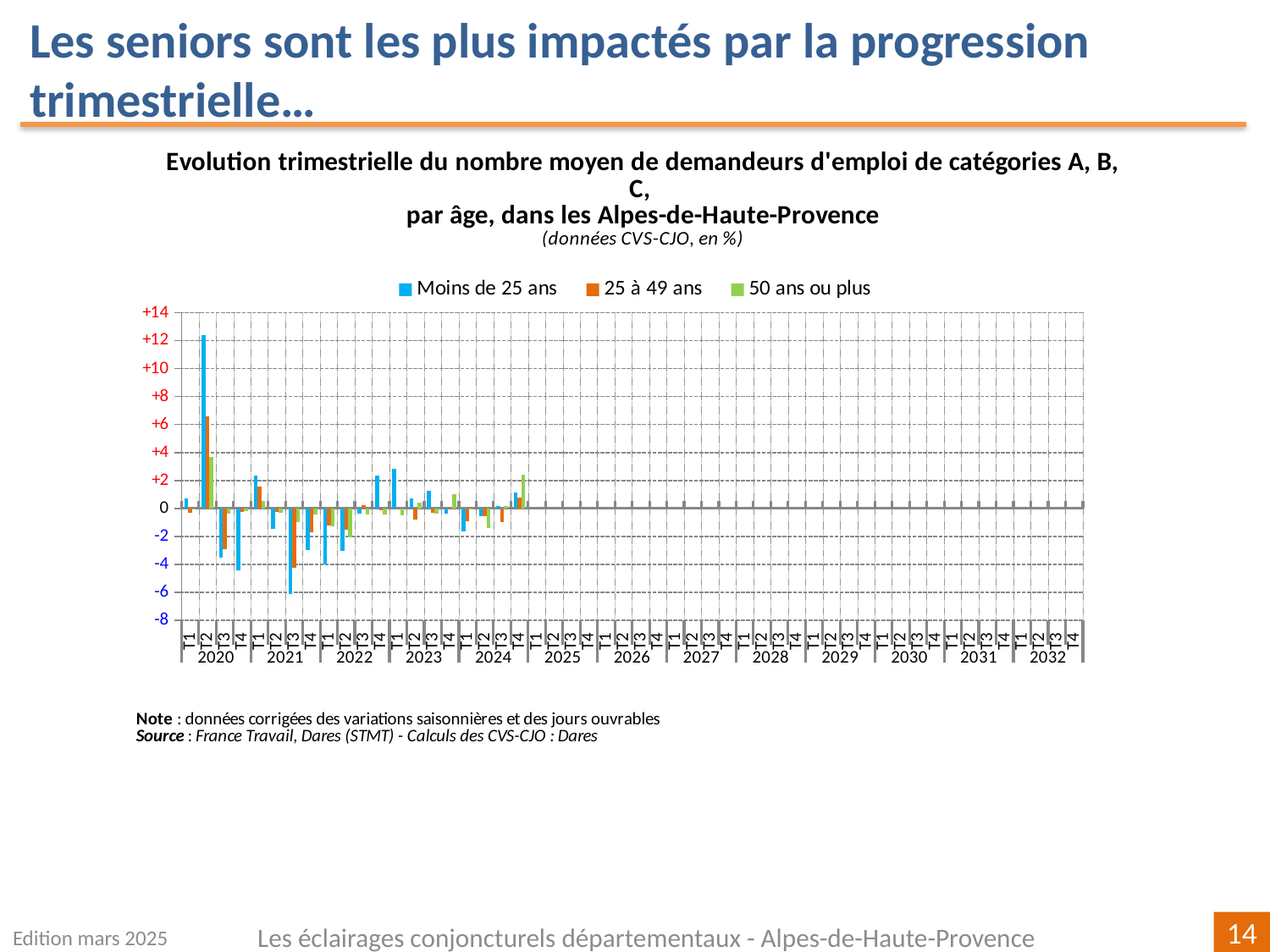
How many series does the legend list? 3 In which quarter does the 'Moins de 25 ans' series reach its lowest value? T3 2021 Is the value for 'Moins de 25 ans' in T2 2020 greater or less than +10? greater Which series is shown in blue in the legend? Moins de 25 ans What kind of chart is shown on the slide? Bar chart For 'Moins de 25 ans', which is larger: the value in T1 2023 or the value in T3 2023? T1 2023 Is the value for 'Moins de 25 ans' in T3 2021 greater or less than -4? less In which quarter does the 'Moins de 25 ans' series reach its highest value? T2 2020 In T2 2020, which is larger: the value for 'Moins de 25 ans' or the value for '25 à 49 ans'? Moins de 25 ans Which series is shown in green in the legend? 50 ans ou plus Which series has the single highest bar on the chart? Moins de 25 ans Is the value for '25 à 49 ans' in T2 2020 greater or less than +4? greater